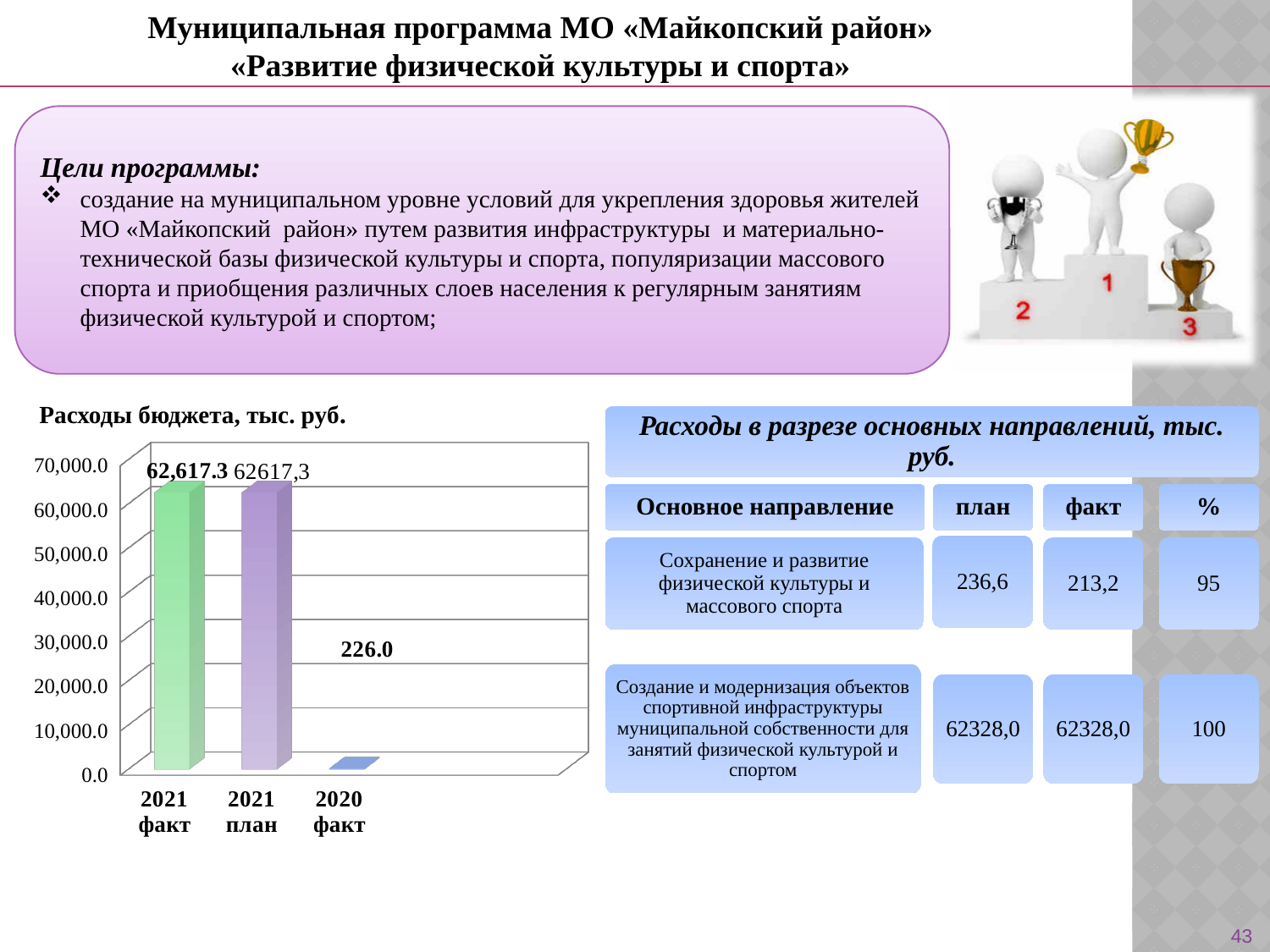
Is the value for 2020 факт in the chart 'Расходы бюджета, тыс. руб.' greater or less than 10,000.0? less How many categories are shown in the chart 'Расходы бюджета, тыс. руб.'? 3 What kind of chart is 'Расходы бюджета, тыс. руб.'? bar chart What is the title of the bar chart on the slide? Расходы бюджета, тыс. руб. Which category has the lowest value in the chart 'Расходы бюджета, тыс. руб.'? 2020 факт Is the value for 2021 план in the chart 'Расходы бюджета, тыс. руб.' greater or less than 60,000.0? greater What is the value for 2021 факт in the chart 'Расходы бюджета, тыс. руб.'? 62,617.3 What is the difference between the 2021 факт and 2020 факт values in the chart 'Расходы бюджета, тыс. руб.'? 62,391.3 What is the value for 2021 план in the chart 'Расходы бюджета, тыс. руб.'? 62617,3 What is the value for 2020 факт in the chart 'Расходы бюджета, тыс. руб.'? 226.0 Do the values in the chart 'Расходы бюджета, тыс. руб.' rise or fall from the first category to the last along the x axis? fall Which is larger in the chart 'Расходы бюджета, тыс. руб.': 2021 факт or 2020 факт? 2021 факт